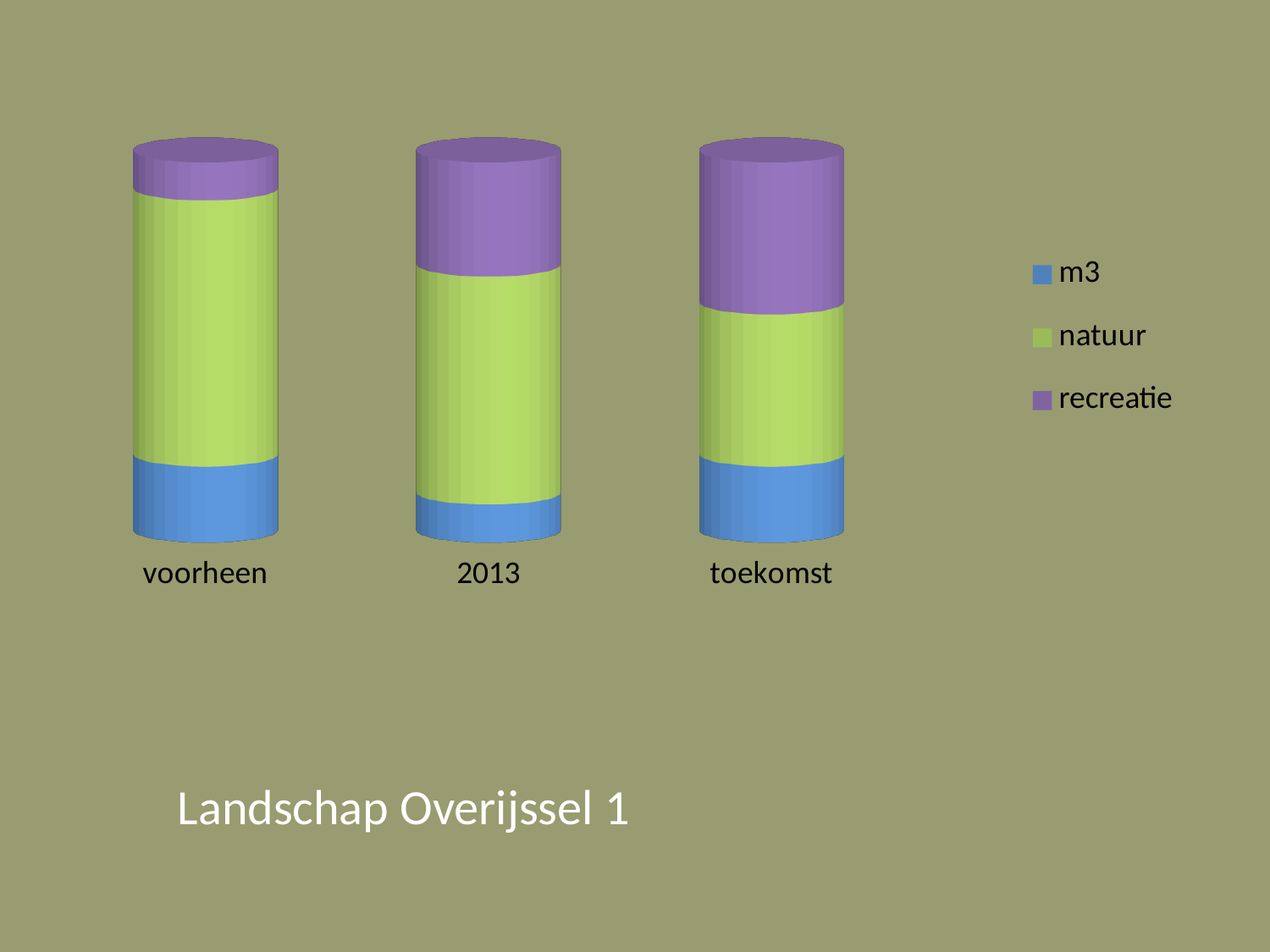
Is the natuur segment larger for voorheen or for toekomst? voorheen What are the three series listed in the chart's legend? m3, natuur, recreatie Does the natuur segment rise or fall from voorheen to toekomst? fall Which category has the smallest recreatie segment? voorheen Which category has the largest recreatie segment? toekomst What kind of chart is shown on the slide? Stacked bar chart Which category has the smallest m3 segment? 2013 How many categories are shown along the x axis of the chart? 3 How many series does the chart's legend list? 3 Which category has the largest natuur segment? voorheen What is the title text shown below the chart? Landschap Overijssel 1 Does the recreatie segment rise or fall from voorheen to toekomst? rise